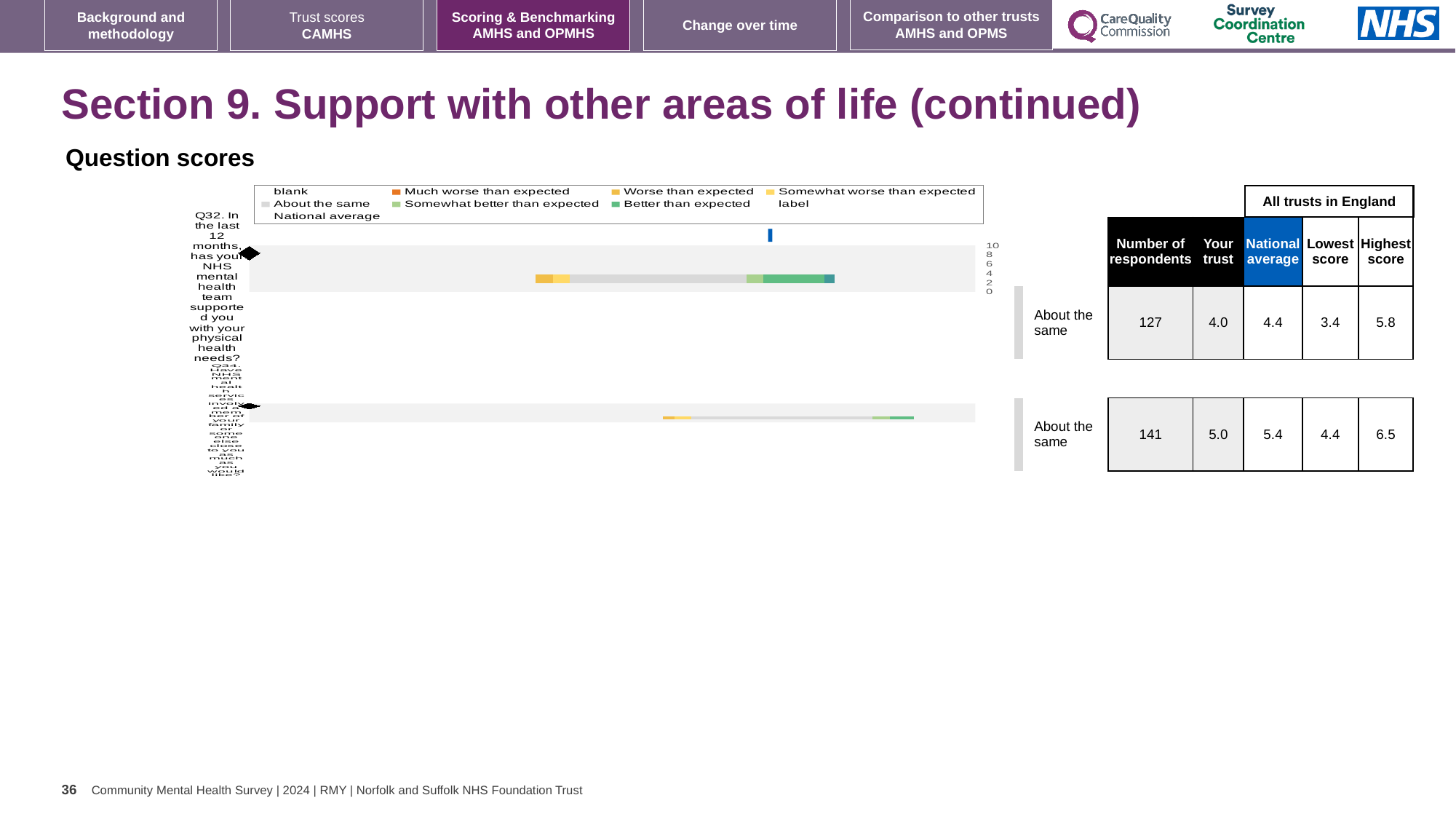
How many questions (categories) are plotted as bars in the chart? 2 Which question has the higher 'Your trust' score, Q32 or Q34? Q34 What is the highest score among all trusts in England for Q34? 6.5 What is the difference between the national average and the trust's score for Q34? 0.4 How many respondents answered Q32? 127 What is the difference between the highest and lowest scores for Q32? 2.4 What is the national average score for Q34 (involving family or someone close)? 5.4 What is the lowest score among all trusts in England for Q32? 3.4 In the chart legend, what colour represents 'Much worse than expected'? orange Which question had more respondents, Q32 or Q34? Q34 What kind of chart is shown on the slide? bar chart What is the 'Your trust' score for Q32 (support with physical health needs)? 4.0